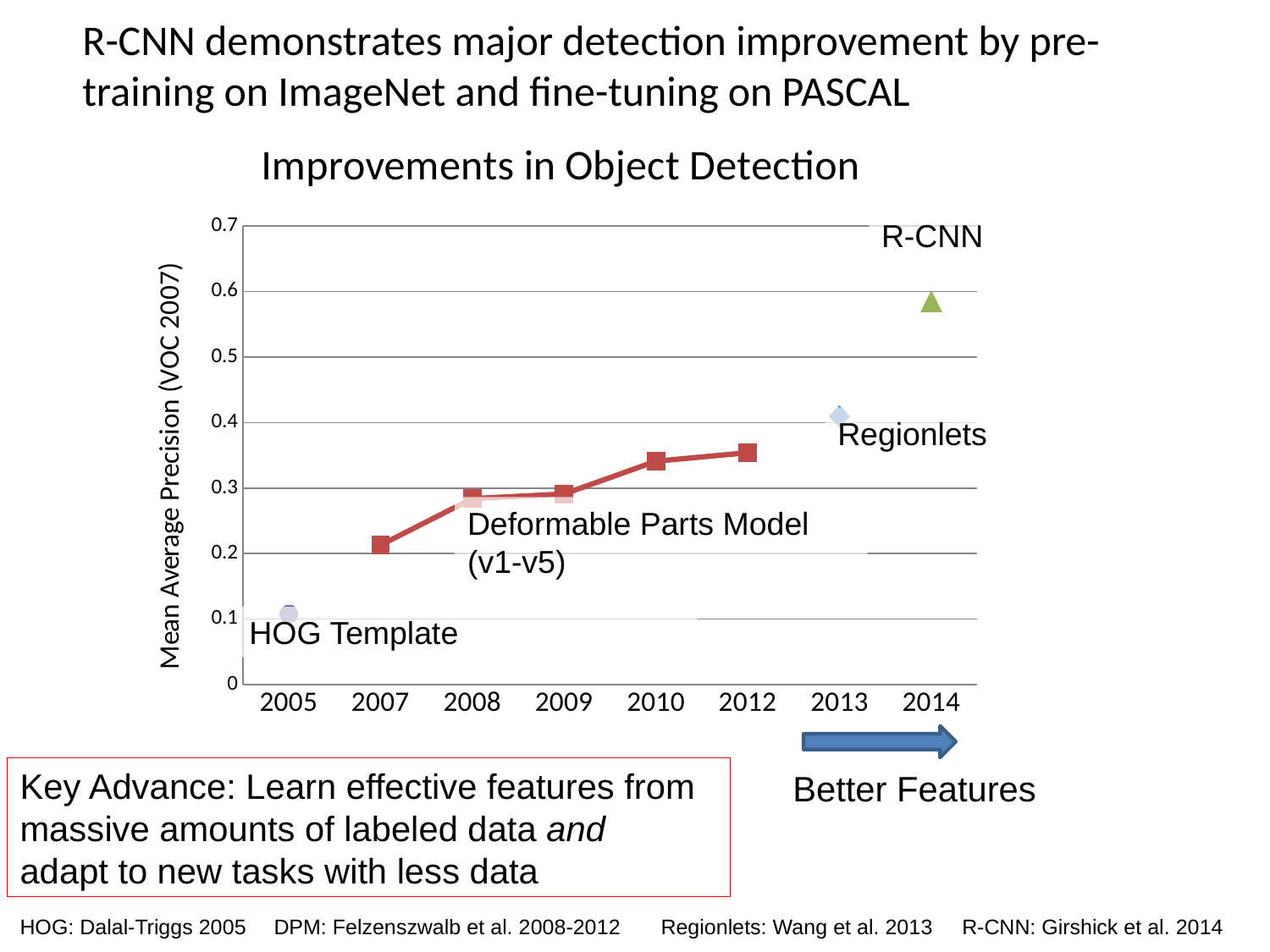
Which has a higher mean average precision, R-CNN or Regionlets? R-CNN Is the value for the Deformable Parts Model in 2010 greater or less than 0.3? greater Is the value for Regionlets greater or less than 0.5? less What is the title of the chart? Improvements in Object Detection Is the value for R-CNN greater or less than 0.5? greater Do the mean average precision values generally rise or fall from 2005 to 2014? rise What is the label of the y axis of the chart? Mean Average Precision (VOC 2007) Which method has the lowest mean average precision on the chart? HOG Template Which method has the highest mean average precision on the chart? R-CNN How many years are shown on the x axis of the chart? 8